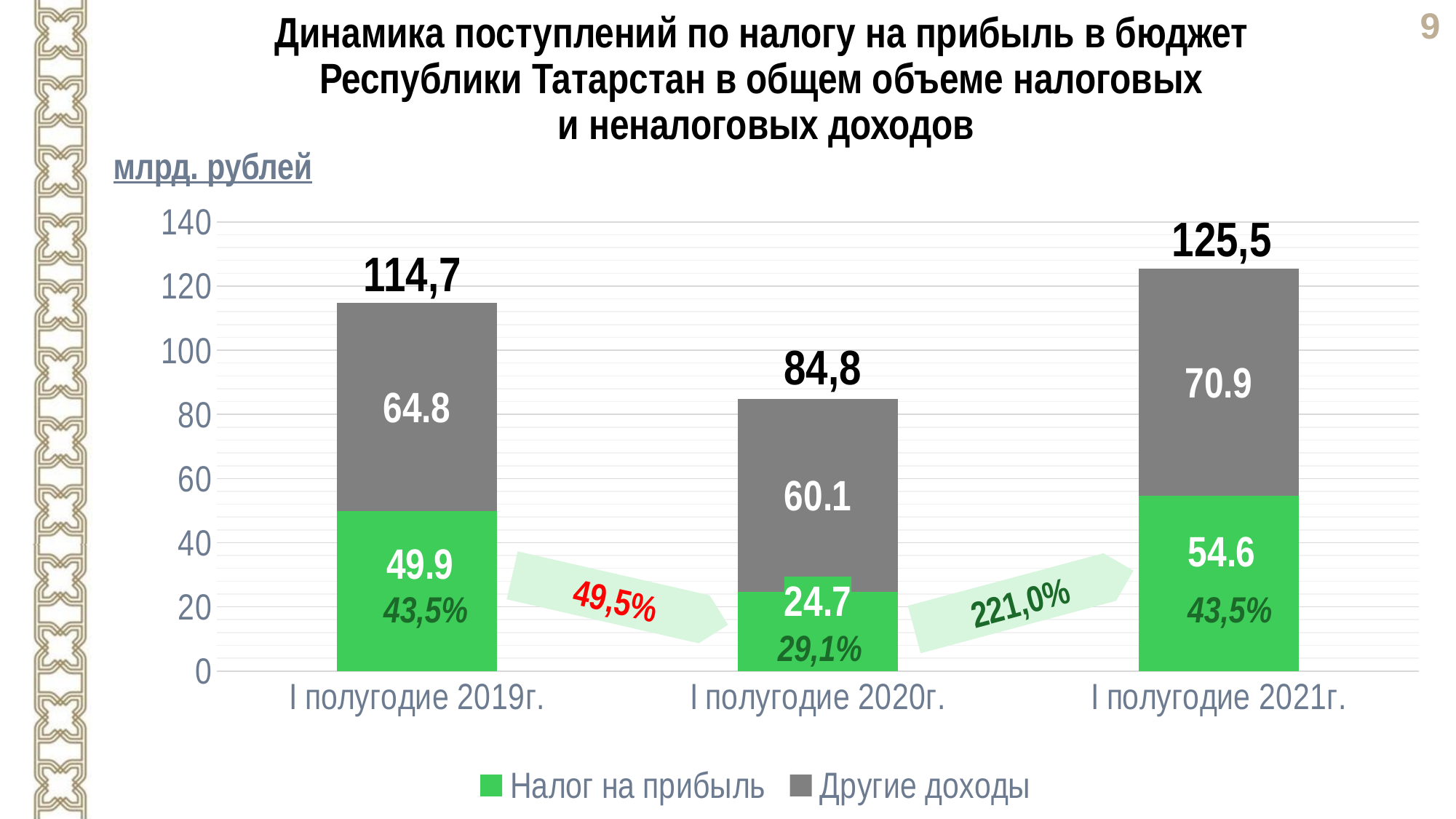
Which period has the lowest total bar? I полугодие 2020г. What is the value of Налог на прибыль for I полугодие 2020г.? 24.7 What is the value of Другие доходы for I полугодие 2021г.? 70.9 What type of chart is shown on the slide? Stacked bar chart What share of the total does Налог на прибыль make up in I полугодие 2020г., as printed on the slide? 29,1% How many periods (categories) are shown on the x axis? 3 Which is larger: Другие доходы for I полугодие 2019г. or for I полугодие 2020г.? I полугодие 2019г. Which period has the highest value for Налог на прибыль? I полугодие 2021г. What unit is indicated above the chart? млрд. рублей What is the difference between the Налог на прибыль values for I полугодие 2021г. and I полугодие 2020г.? 29.9 How many series does the legend list? 2 What is the total of the stacked bar for I полугодие 2019г.? 114,7